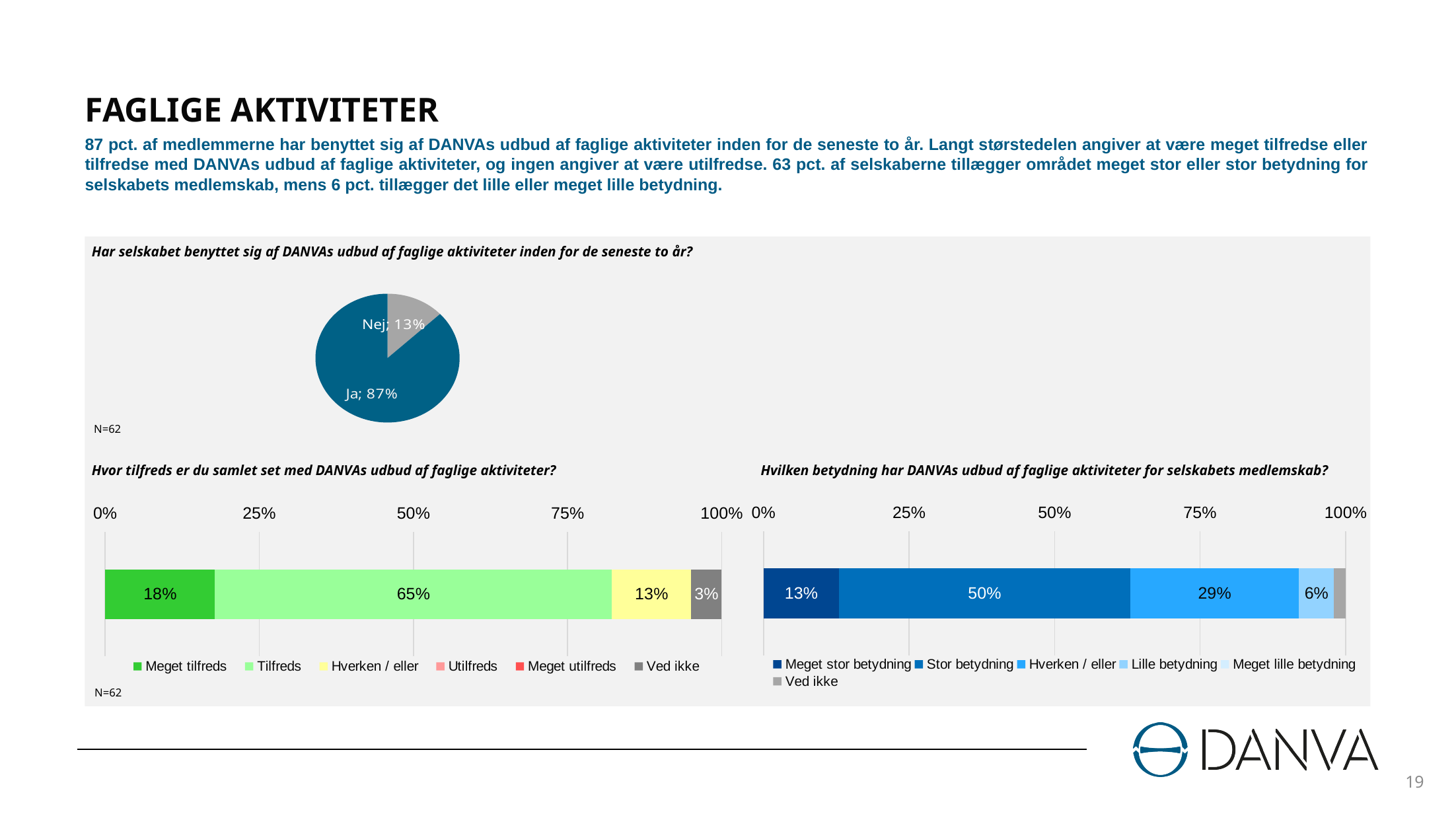
In the chart 'Hvor tilfreds er du samlet set med DANVAs udbud af faglige aktiviteter?', what is the difference between 'Tilfreds' and 'Meget tilfreds'? 47% In the pie chart 'Har selskabet benyttet sig af DANVAs udbud af faglige aktiviteter inden for de seneste to år?', what share is labelled 'Ja'? 87% In the chart 'Hvor tilfreds er du samlet set med DANVAs udbud af faglige aktiviteter?', what is the value for 'Meget tilfreds'? 18% In the chart 'Hvilken betydning har DANVAs udbud af faglige aktiviteter for selskabets medlemskab?', what is the value for 'Hverken / eller'? 29% In the chart 'Hvilken betydning har DANVAs udbud af faglige aktiviteter for selskabets medlemskab?', which labelled segment has the highest value? Stor betydning In the chart 'Hvilken betydning har DANVAs udbud af faglige aktiviteter for selskabets medlemskab?', what is the value for 'Stor betydning'? 50% In the chart 'Hvor tilfreds er du samlet set med DANVAs udbud af faglige aktiviteter?', how many series does the legend list? 6 In the chart 'Hvilken betydning har DANVAs udbud af faglige aktiviteter for selskabets medlemskab?', which is larger: 'Meget stor betydning' or 'Hverken / eller'? Hverken / eller In the chart 'Hvor tilfreds er du samlet set med DANVAs udbud af faglige aktiviteter?', what is the value for 'Tilfreds'? 65% What kind of chart is 'Hvor tilfreds er du samlet set med DANVAs udbud af faglige aktiviteter?'? Stacked bar chart In the pie chart 'Har selskabet benyttet sig af DANVAs udbud af faglige aktiviteter inden for de seneste to år?', how many slices are there? 2 In the pie chart 'Har selskabet benyttet sig af DANVAs udbud af faglige aktiviteter inden for de seneste to år?', what share is labelled 'Nej'? 13%